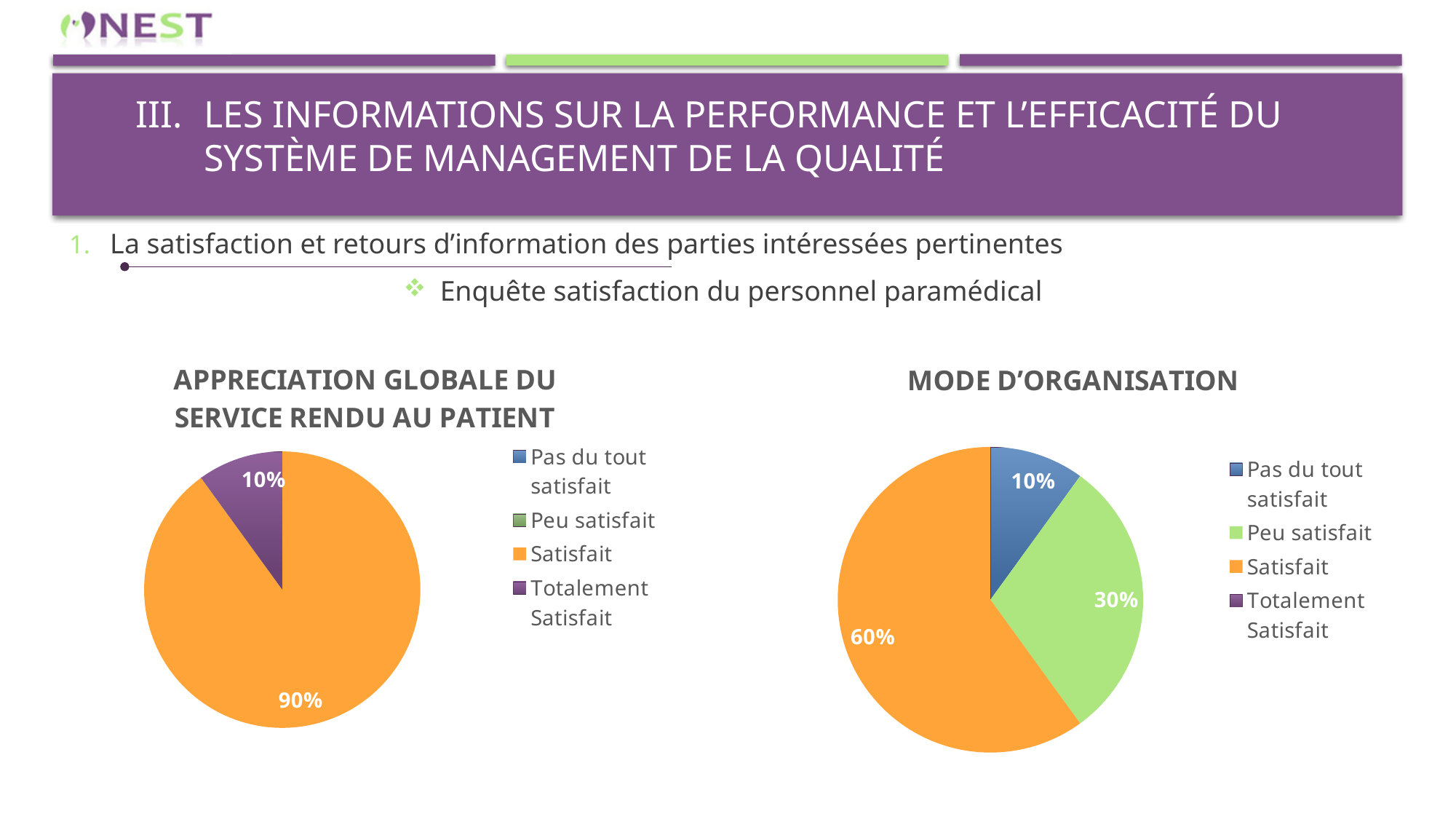
In the 'MODE D'ORGANISATION' chart, which category has the smallest visible slice? Pas du tout satisfait In the 'MODE D'ORGANISATION' chart, what share is 'Peu satisfait'? 30% In the 'MODE D'ORGANISATION' chart, what share is 'Pas du tout satisfait'? 10% What type of chart is the 'MODE D'ORGANISATION' chart? Pie chart In the 'APPRECIATION GLOBALE DU SERVICE RENDU AU PATIENT' chart, which is larger: 'Satisfait' or 'Totalement Satisfait'? Satisfait In the 'MODE D'ORGANISATION' chart, what share is 'Satisfait'? 60% In the 'APPRECIATION GLOBALE DU SERVICE RENDU AU PATIENT' chart, what share is 'Totalement Satisfait'? 10% In the 'MODE D'ORGANISATION' chart, what colour is the 'Peu satisfait' slice? Green In the 'MODE D'ORGANISATION' chart, which category has the largest slice? Satisfait How many entries does the legend of the 'APPRECIATION GLOBALE DU SERVICE RENDU AU PATIENT' chart list? 4 In the 'APPRECIATION GLOBALE DU SERVICE RENDU AU PATIENT' chart, what share is 'Satisfait'? 90% In the 'MODE D'ORGANISATION' chart, what is the difference between the 'Satisfait' and 'Peu satisfait' shares? 30%